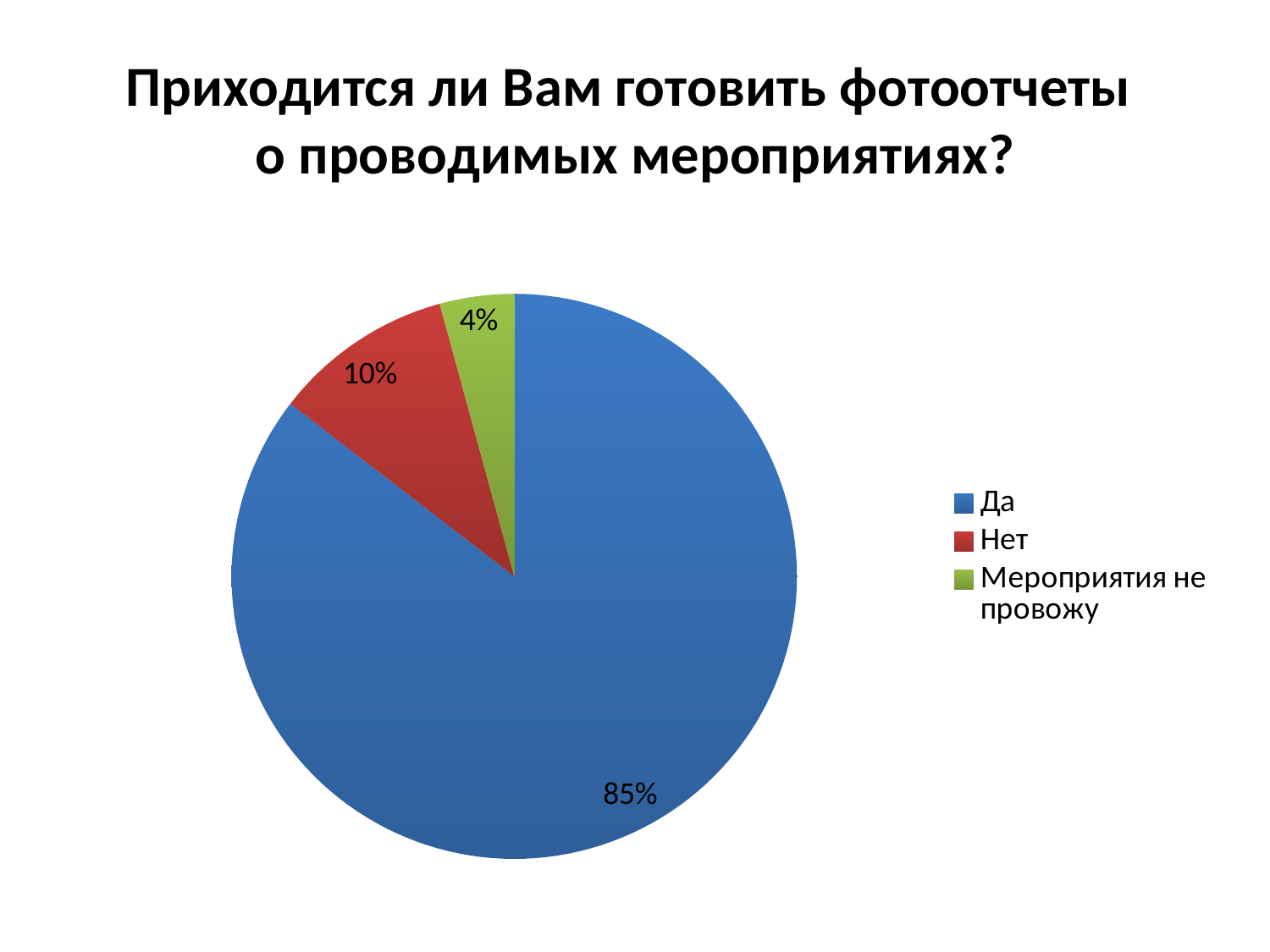
What is the value shown for "Мероприятия не провожу"? 4% What colour is the slice for "Нет"? red What is the title of the chart? Приходится ли Вам готовить фотоотчеты о проводимых мероприятиях? What is the difference between the shares for "Нет" and "Мероприятия не провожу"? 6% Which category has the smallest slice of the pie? Мероприятия не провожу What is the value shown for "Нет"? 10% What share of the pie does "Да" take? 85% How many slices does the pie chart have? 3 What is the difference between the shares for "Да" and "Нет"? 75% Which is larger, the share for "Нет" or the share for "Мероприятия не провожу"? Нет Which category has the largest slice of the pie? Да What kind of chart is shown on the slide? pie chart